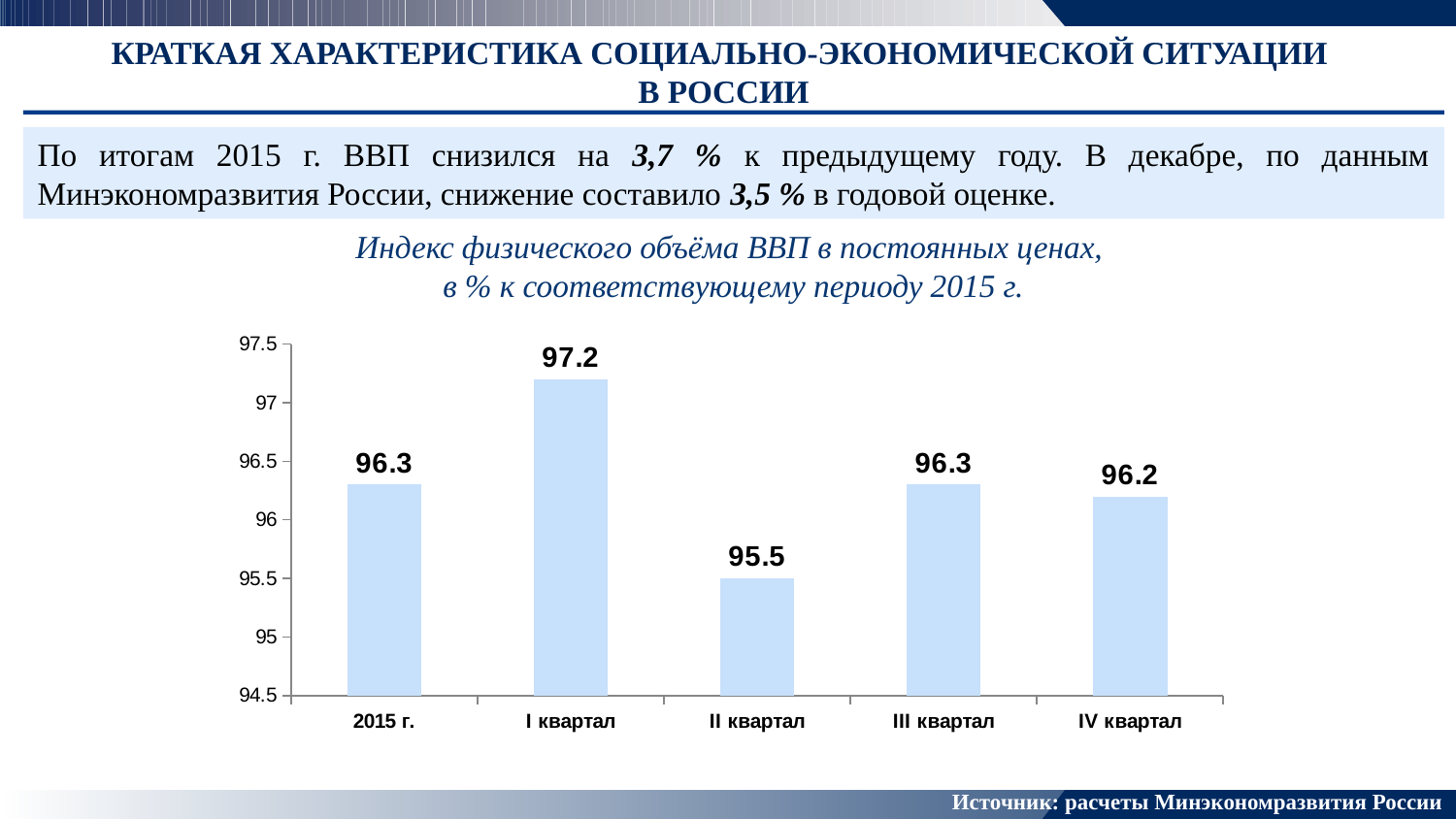
Which is larger, the value for III квартал or the value for IV квартал? III квартал What is the value for II квартал? 95.5 What is the value for 2015 г.? 96.3 What is the value for IV квартал? 96.2 What kind of chart is shown on the slide? bar chart Do the values rise or fall from I квартал to II квартал? fall Which category has the highest value? I квартал What is the value for I квартал? 97.2 Which category has the lowest value? II квартал Is the value for II квартал greater or less than 96? less How many categories are shown on the x axis? 5 What is the difference between the values for I квартал and II квартал? 1.7